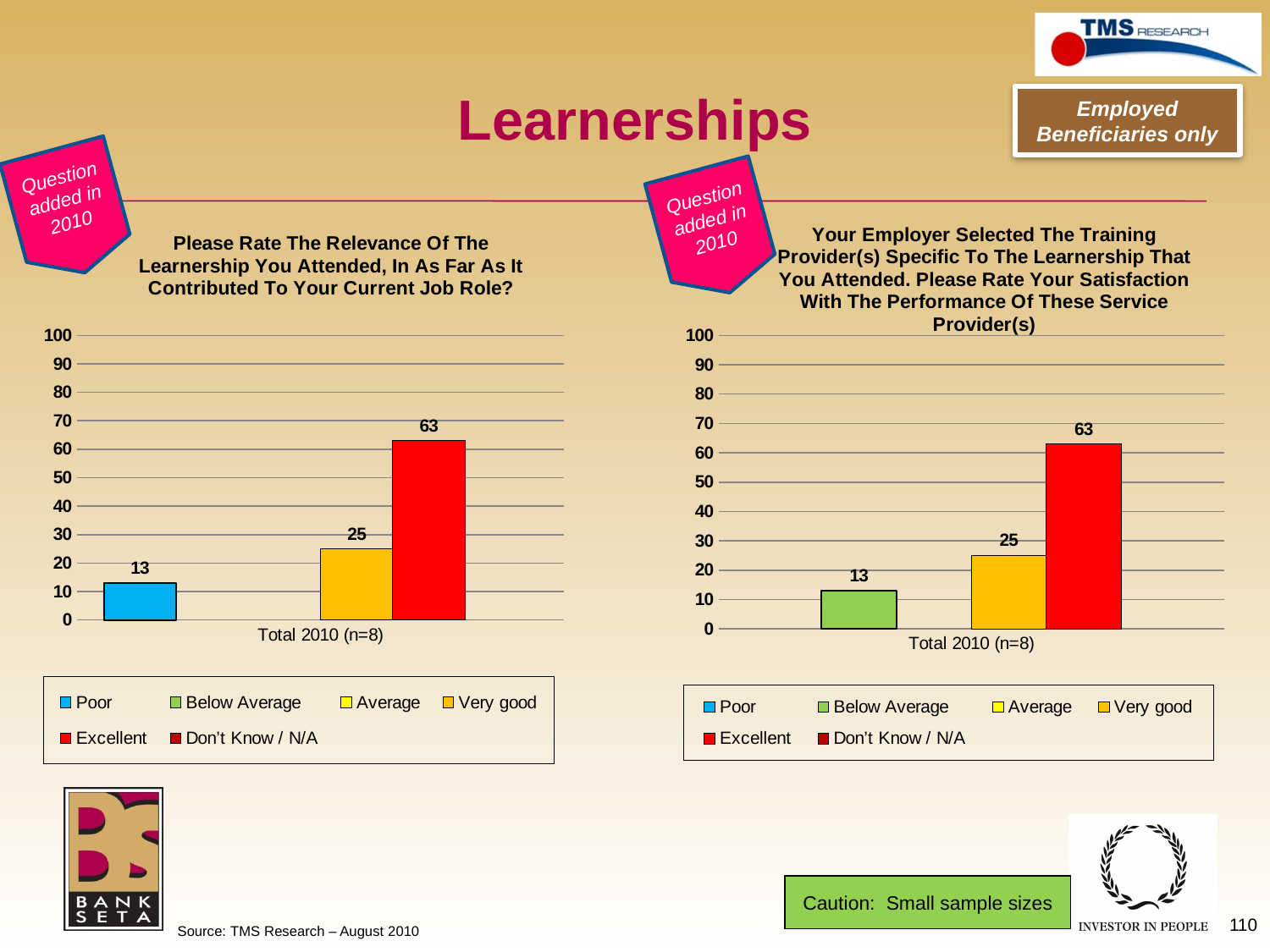
On the right chart (satisfaction with service providers), what value is shown for Below Average? 13 On the right chart (satisfaction with service providers), what value is shown for Excellent? 63 On the left chart (relevance of the learnership), which rating has the highest value? Excellent On the left chart (relevance of the learnership), what value is shown for Excellent? 63 On the left chart (relevance of the learnership), what is the difference between the Excellent value and the Poor value? 50 What is the x-axis category label on the left chart (relevance of the learnership)? Total 2010 (n=8) How many series does the legend of the left chart (relevance of the learnership) list? 6 On the left chart (relevance of the learnership), what value is shown for Poor? 13 On the right chart (satisfaction with service providers), which is larger: the value for Excellent or the value for Below Average? Excellent On the right chart (satisfaction with service providers), which rating has the lowest value? Below Average On the right chart (satisfaction with service providers), what is the difference between the Excellent value and the Below Average value? 50 What type of chart is the right chart (satisfaction with service providers)? Bar chart